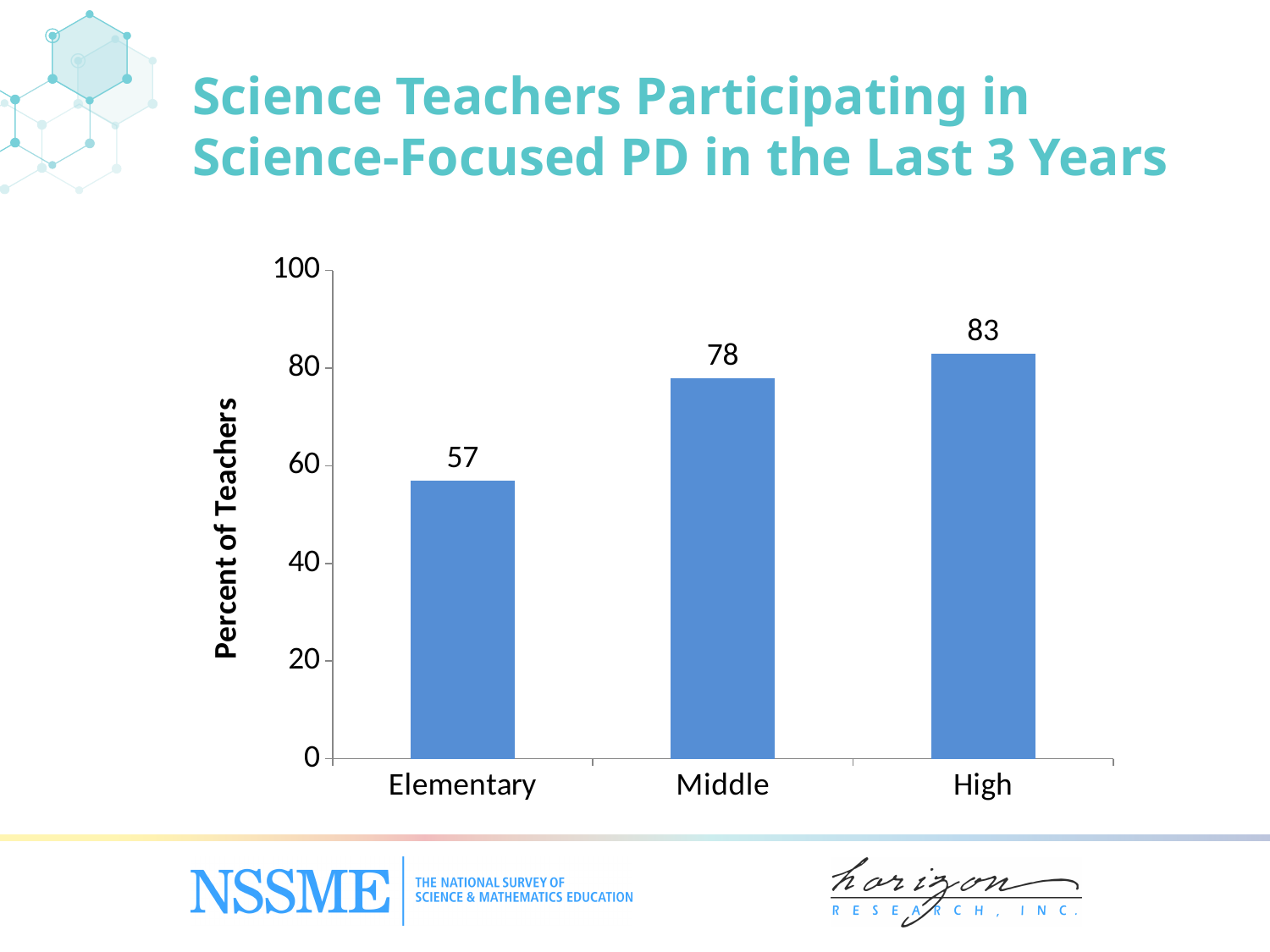
What is the difference between the High and Elementary values? 26 What is the value shown for Middle school teachers? 78 What is the difference between the Middle and Elementary values? 21 Which is larger, the value for Middle or the value for Elementary? Middle What is the value shown for High school teachers? 83 What percent of elementary science teachers participated in science-focused PD in the last 3 years? 57 Which grade level has the lowest percent of teachers participating in science-focused PD? Elementary Is the value for Elementary greater or less than 60? less What kind of chart is shown on the slide? Bar chart How many grade-level categories are shown on the x axis? 3 Which grade level has the highest percent of teachers participating in science-focused PD? High Do the values rise or fall moving from Elementary to High along the x axis? Rise